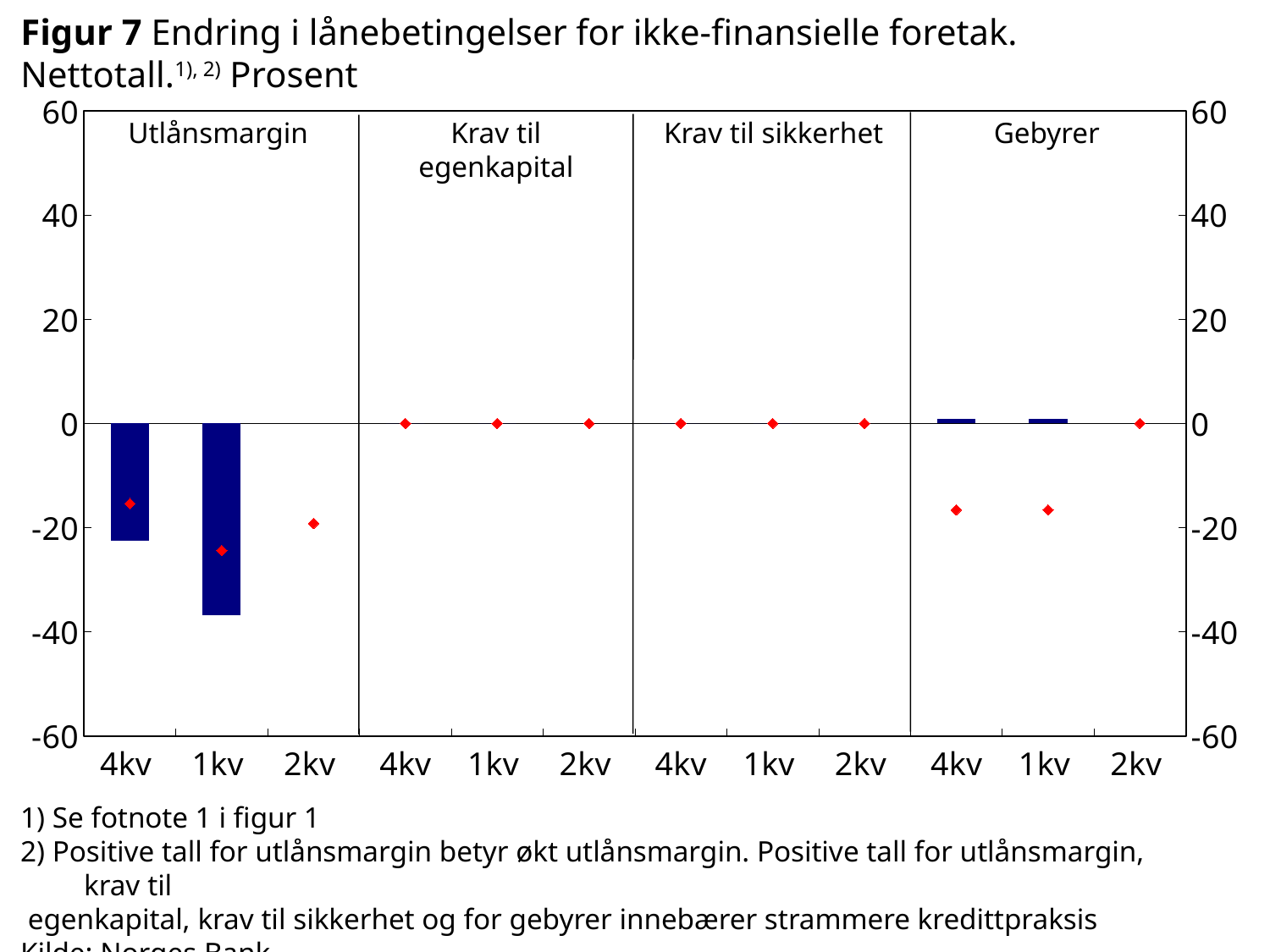
Is the bar for 1kv in the Utlånsmargin panel greater or less than -20? less How many panels (loan condition categories) does the chart have? 4 In the Utlånsmargin panel, which quarter has the lowest bar? 1kv What is the figure number given in the chart title? Figur 7 Is the bar for 4kv in the Utlånsmargin panel greater or less than -20? less What value do the red diamonds show for all three quarters in the Krav til egenkapital panel? 0 In the Utlånsmargin panel, is the bar for 4kv or the bar for 1kv lower? 1kv What is the maximum value shown on the vertical axis? 60 How many quarters are shown within each panel of the chart? 3 What kind of chart is shown on the slide? bar chart Is the red diamond for 4kv in the Gebyrer panel greater or less than 0? less